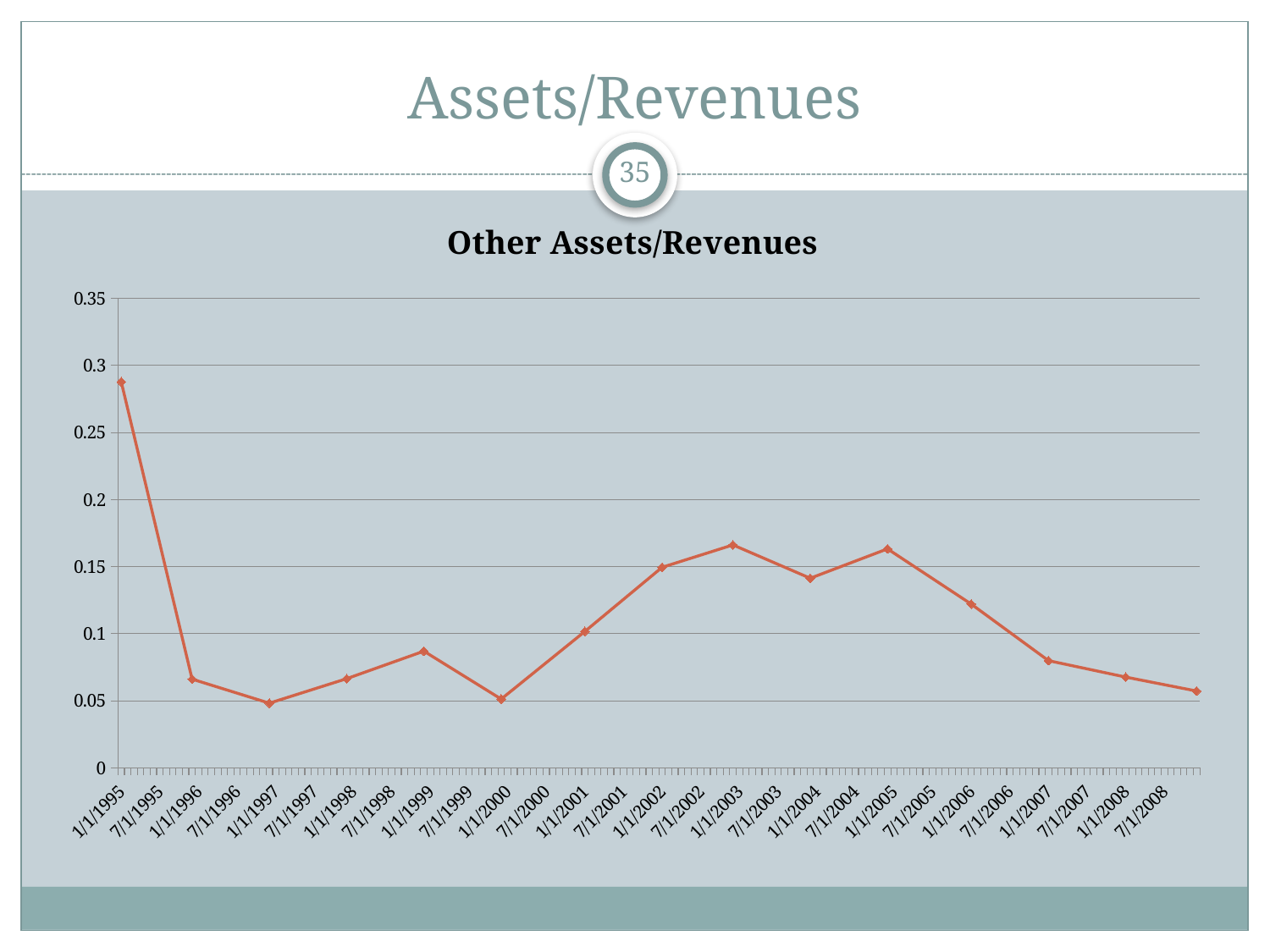
How many data points are plotted on the line? 15 Which is larger, the value for 1/1/2003 or the value for 1/1/2004? 1/1/2003 Is the value for 1/1/2006 greater or less than 0.1? greater Is the value for 1/1/2004 greater or less than 0.15? less What is the title of the chart? Other Assets/Revenues What kind of chart is shown on the slide? line chart Which date has the highest value on the chart? 1/1/1995 Do the values rise or fall from 1/1/2000 to 1/1/2003? rise Is the value for 1/1/1995 greater or less than 0.25? greater Do the values rise or fall from 1/1/2005 to 1/1/2008? fall